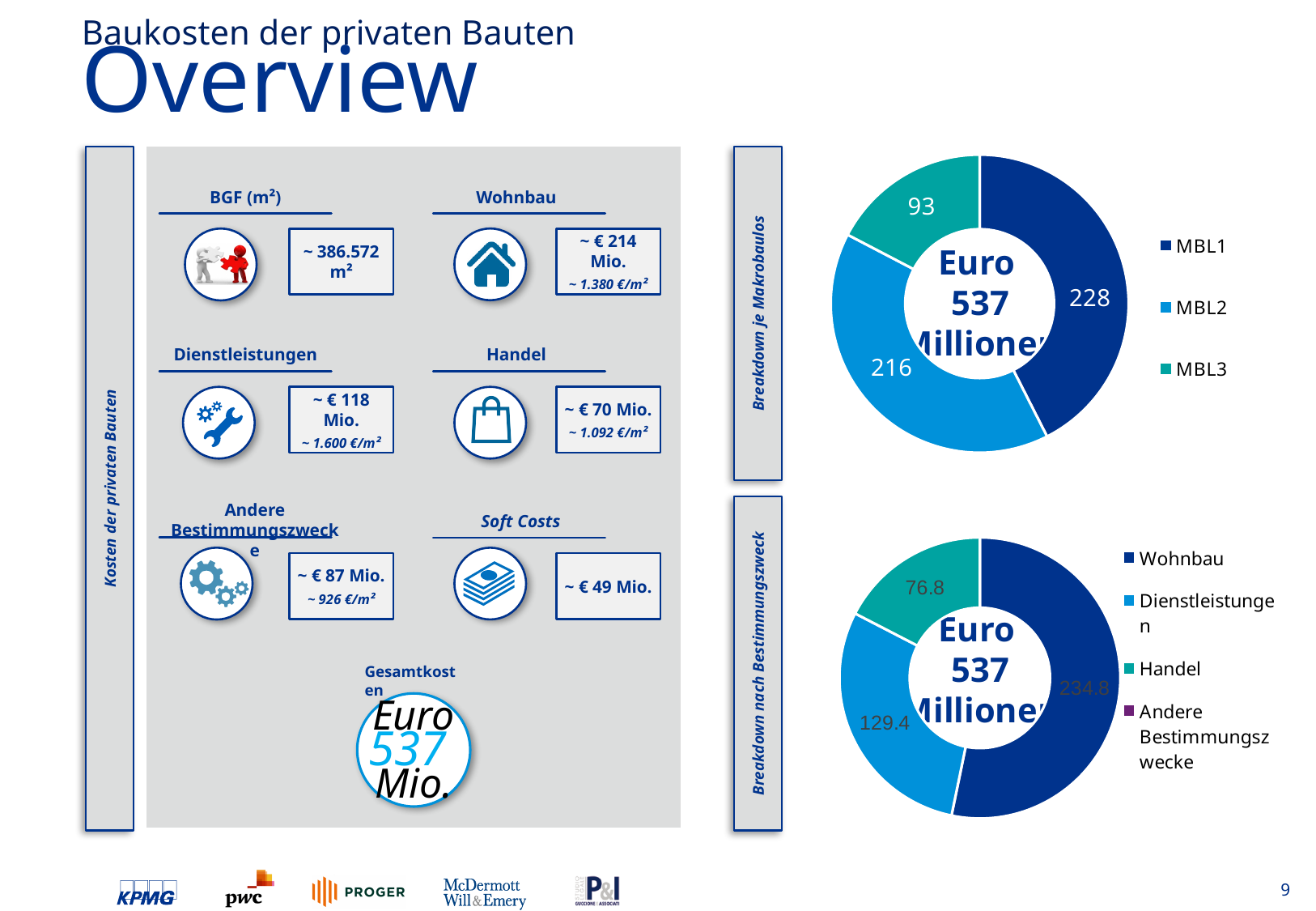
In the top doughnut chart (Breakdown je Makrobaulos), what is the value for MBL1? 228 In the bottom doughnut chart (Breakdown nach Bestimmungszwecke), what is the difference between the values for Wohnbau and Dienstleistungen? 105.4 In the bottom doughnut chart (Breakdown nach Bestimmungszwecke), what is the value for Wohnbau? 234.8 How many entries does the legend of the top doughnut chart (Breakdown je Makrobaulos) list? 3 In the bottom doughnut chart (Breakdown nach Bestimmungszwecke), which is larger: Dienstleistungen or Handel? Dienstleistungen In the top doughnut chart (Breakdown je Makrobaulos), what is the sum of the three labelled values? 537 In the bottom doughnut chart (Breakdown nach Bestimmungszwecke), which category has the largest value? Wohnbau In the top doughnut chart (Breakdown je Makrobaulos), which category has the smallest value? MBL3 In the top doughnut chart (Breakdown je Makrobaulos), what is the difference between the values for MBL1 and MBL2? 12 What type of chart is used for the Breakdown nach Bestimmungszwecke on the slide? Doughnut chart In the bottom doughnut chart (Breakdown nach Bestimmungszwecke), what is the value for Handel? 76.8 In the top doughnut chart (Breakdown je Makrobaulos), what is the value for MBL3? 93